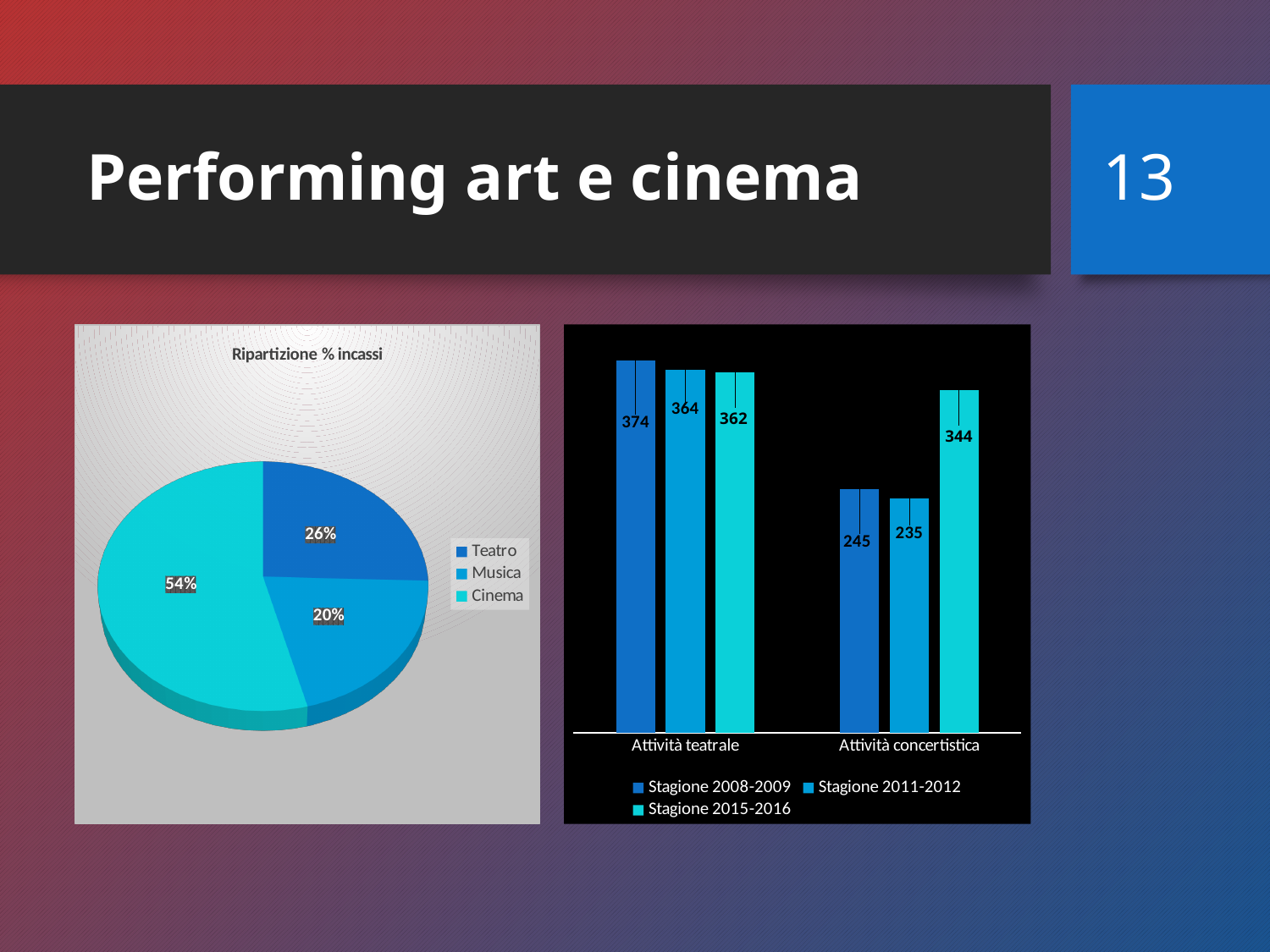
In the bar chart on the right, what is the difference between Attività teatrale and Attività concertistica in Stagione 2008-2009? 129 In the bar chart on the right, what is the value for Attività concertistica in Stagione 2015-2016? 344 In the bar chart on the right, which is larger: Attività concertistica in Stagione 2015-2016 or in Stagione 2011-2012? Stagione 2015-2016 In the pie chart 'Ripartizione % incassi', what is the difference in percentage points between Cinema and Musica? 34 In the bar chart on the right, which season has the lowest value for Attività concertistica? Stagione 2011-2012 In the bar chart on the right, what is the value for Attività teatrale in Stagione 2008-2009? 374 In the bar chart on the right, how many series does the legend list? 3 What kind of chart is the chart on the left of the slide? Pie chart In the pie chart 'Ripartizione % incassi', what share does Teatro have? 26% In the pie chart 'Ripartizione % incassi', which category has the smallest share? Musica In the pie chart 'Ripartizione % incassi', how many categories does the legend list? 3 In the pie chart 'Ripartizione % incassi', what share does Cinema have? 54%